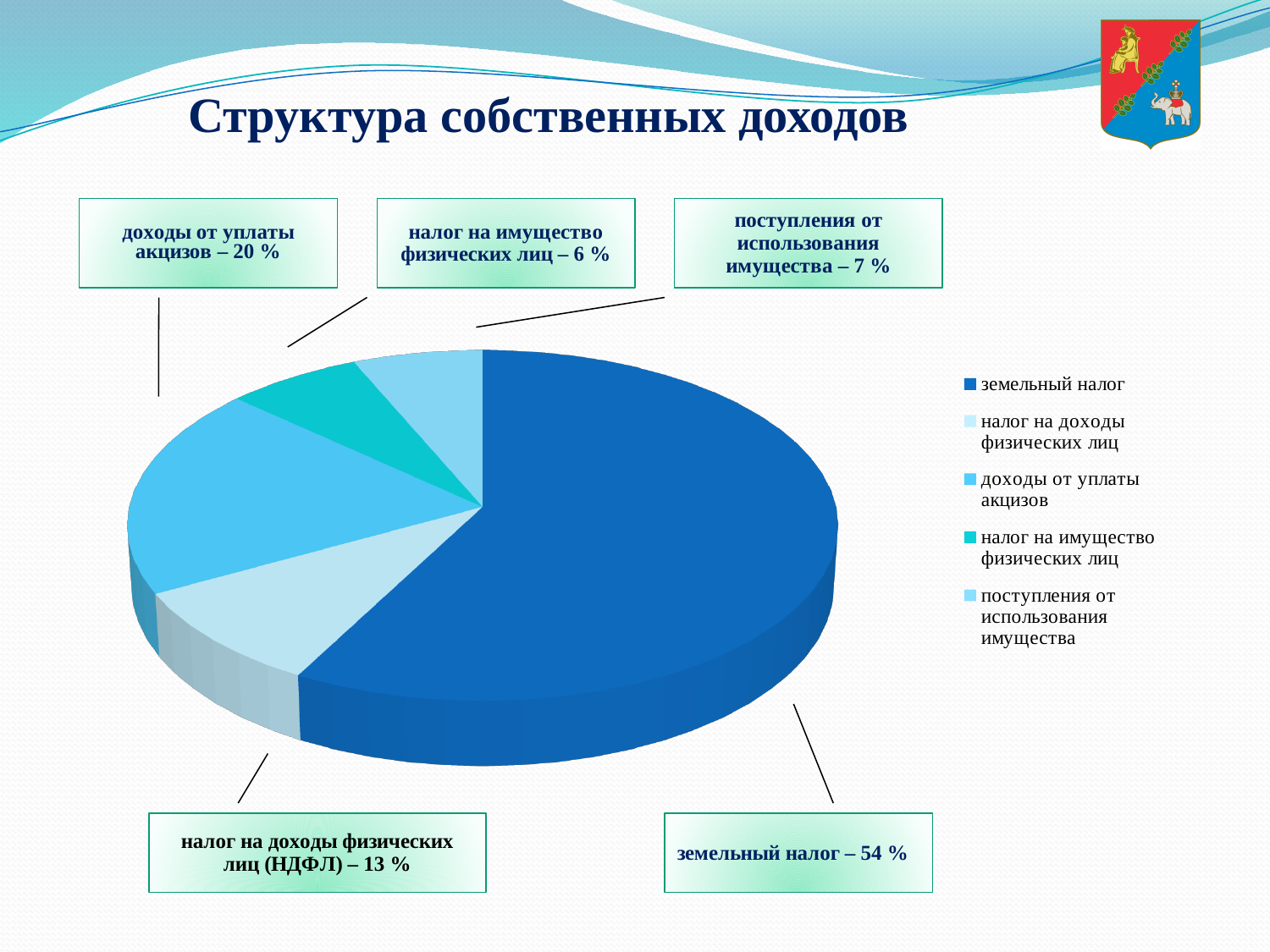
Which is larger: the share of НДФЛ or the share of поступления от использования имущества? НДФЛ Which category has the smallest share of the pie? налог на имущество физических лиц Which category has the largest share of the pie? земельный налог What is the value for поступления от использования имущества? 7 % What is the value shown for доходы от уплаты акцизов? 20 % What share of own revenues does земельный налог account for? 54 % What is the title of the slide? Структура собственных доходов How many slices does the pie chart have? 5 What is the difference between the share of земельный налог and the share of доходы от уплаты акцизов? 34 % What type of chart is shown on the slide? Pie chart What percentage is shown for налог на доходы физических лиц (НДФЛ)? 13 % What is the value for налог на имущество физических лиц? 6 %